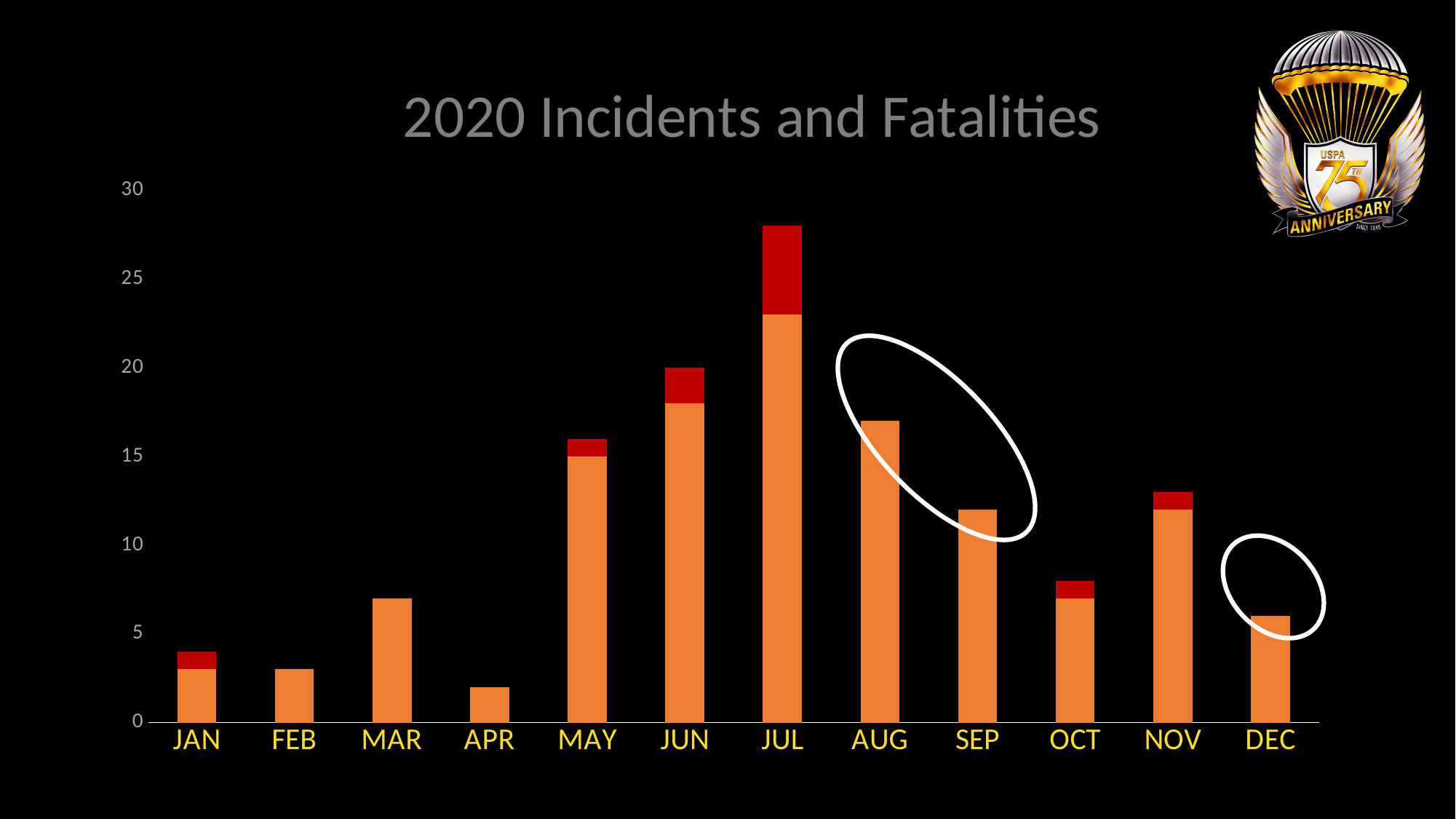
Which bar is taller, JUN or SEP? JUN Which bar is taller, MAR or FEB? MAR What kind of chart is shown on the slide? bar chart Is the value for APR greater or less than 5? less Is the value for OCT greater or less than 10? less Is the value for DEC greater or less than 5? greater Which month has the tallest bar in the chart? JUL How many months are shown on the x axis of the chart? 12 What is the title of the chart? 2020 Incidents and Fatalities Which month has the shortest bar in the chart? APR